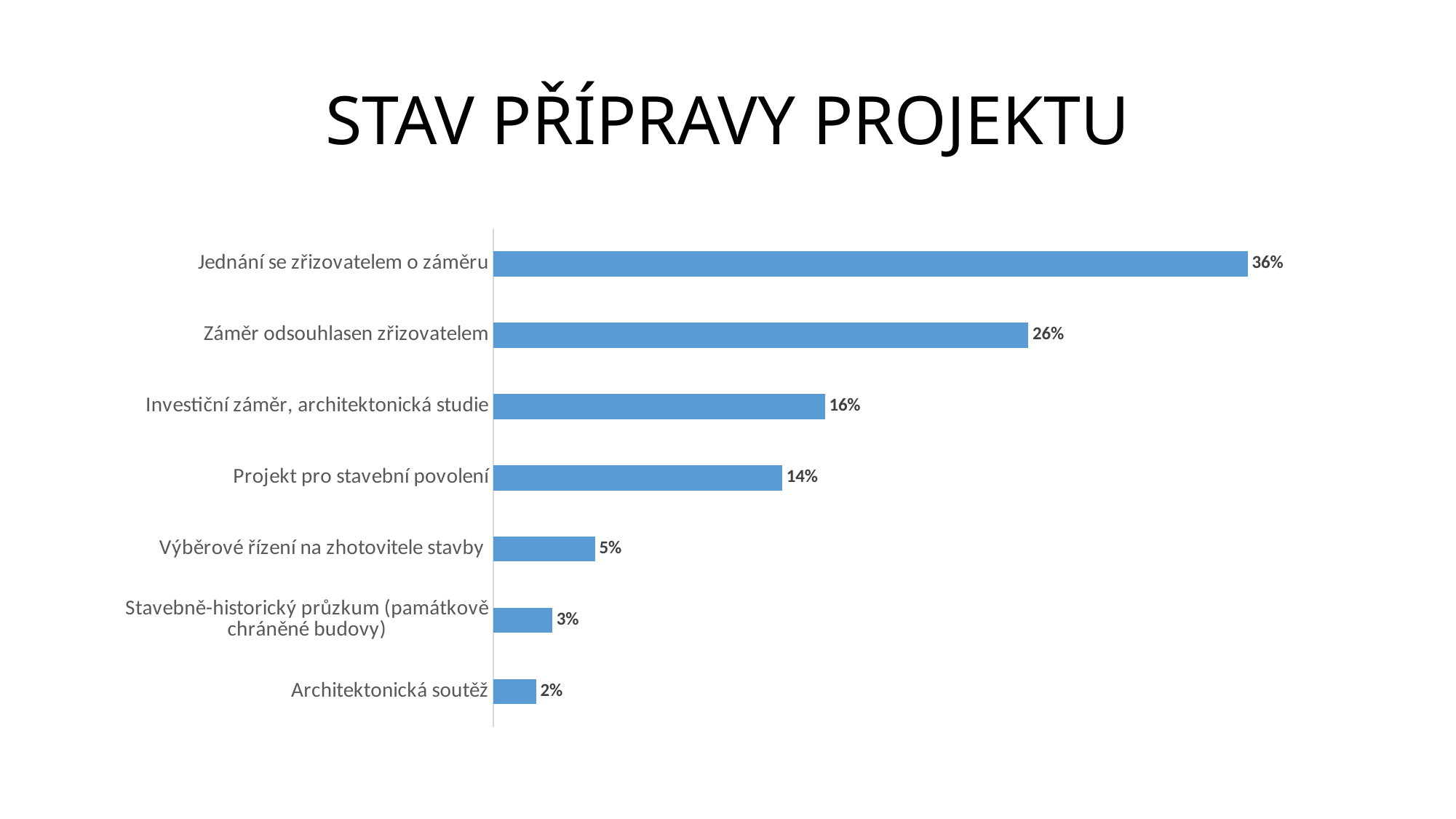
What is the value for "Stavebně-historický průzkum (památkově chráněné budovy)"? 3% How many categories are shown in the chart? 7 What colour are the bars in the chart? Blue What is the value for "Projekt pro stavební povolení"? 14% What is the title of the slide? STAV PŘÍPRAVY PROJEKTU What kind of chart is shown on the slide? Bar chart Which category has the lowest value? Architektonická soutěž What is the value for "Jednání se zřizovatelem o záměru"? 36% What is the difference between "Jednání se zřizovatelem o záměru" and "Záměr odsouhlasen zřizovatelem"? 10% Which category has the highest value? Jednání se zřizovatelem o záměru Which is larger: "Výběrové řízení na zhotovitele stavby" or "Architektonická soutěž"? Výběrové řízení na zhotovitele stavby What is the difference between "Záměr odsouhlasen zřizovatelem" and "Investiční záměr, architektonická studie"? 10%